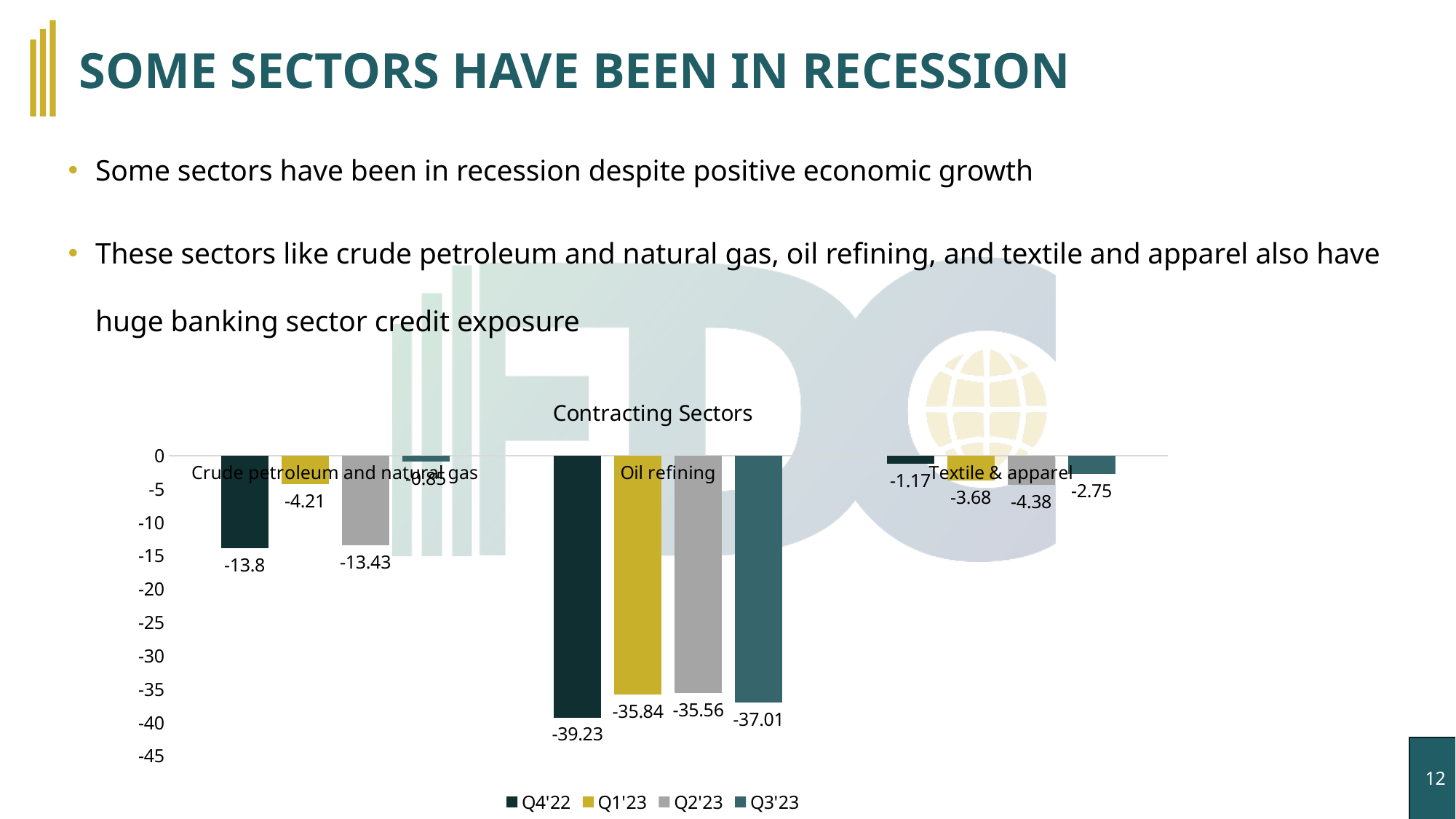
What type of chart is shown on the slide? bar chart What is the Q4'22 value for Oil refining? -39.23 What is the difference between the Q4'22 and Q2'23 values for Crude petroleum and natural gas? 0.37 What is the Q1'23 value for Crude petroleum and natural gas? -4.21 Which quarter has the lowest value for Textile & apparel? Q2'23 What is the title of the chart on the slide? Contracting Sectors What is the Q2'23 value for Textile & apparel? -4.38 Which sector has the lowest Q4'22 value? Oil refining What is the Q3'23 value for Oil refining? -37.01 How many sector categories are shown on the x axis of the chart? 3 Which is larger, the Q1'23 value for Oil refining or the Q3'23 value for Oil refining? Q1'23 (-35.84) How many series does the chart legend list? 4